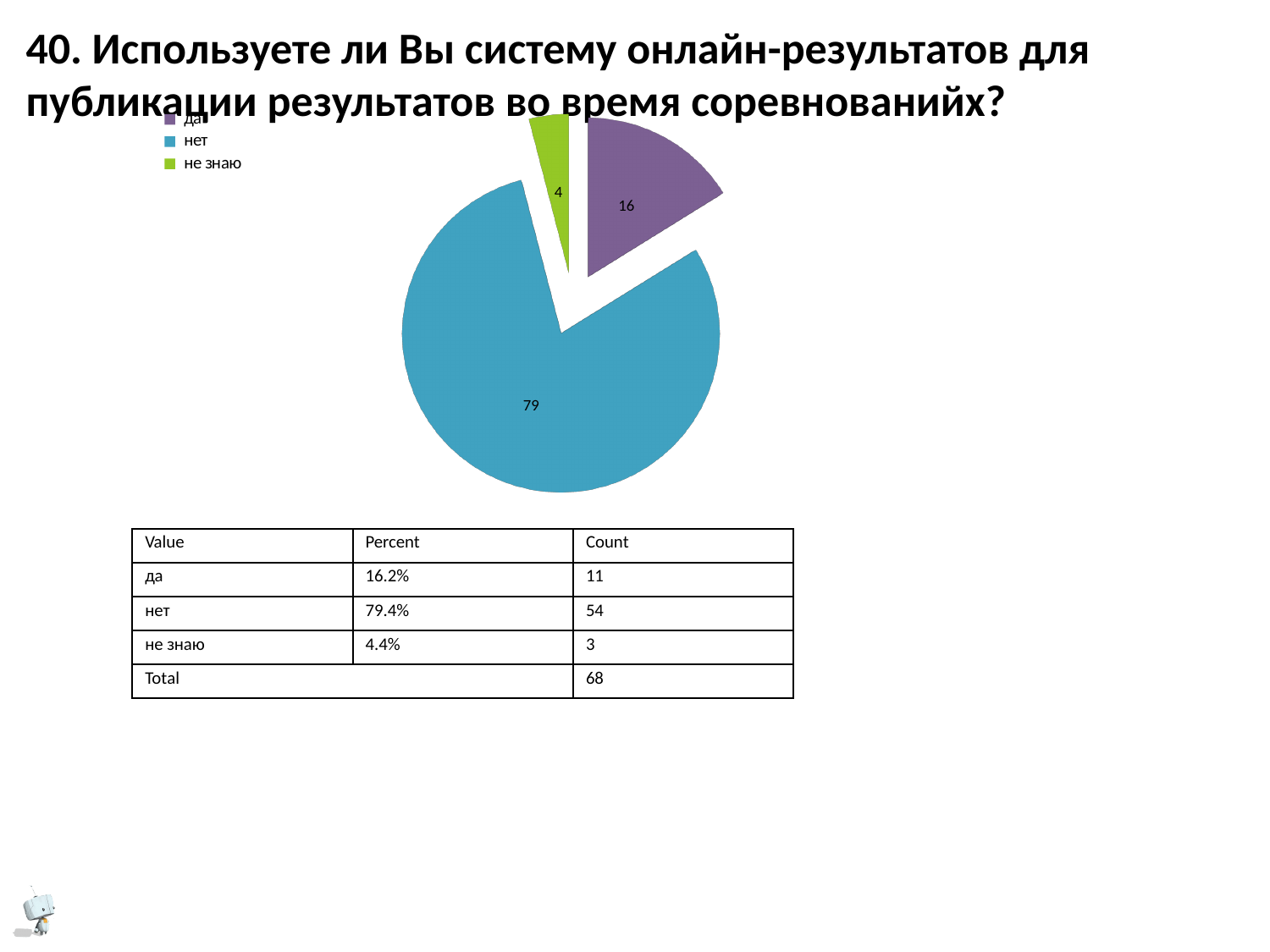
Which category has the largest slice in the pie chart? нет What colour is the "нет" slice in the pie chart? blue How many slices does the pie chart have? 3 What type of chart is shown on the slide? pie chart Which category has the smallest slice in the pie chart? не знаю What value is labelled on the pie slice for "не знаю"? 4 What colour is the "не знаю" slice in the pie chart? green What value is labelled on the pie slice for "да"? 16 Which slice is larger in the pie chart, "да" or "не знаю"? да What value is labelled on the pie slice for "нет"? 79 How many entries does the legend of the pie chart list? 3 What is the difference between the labelled values of the "нет" and "да" slices? 63